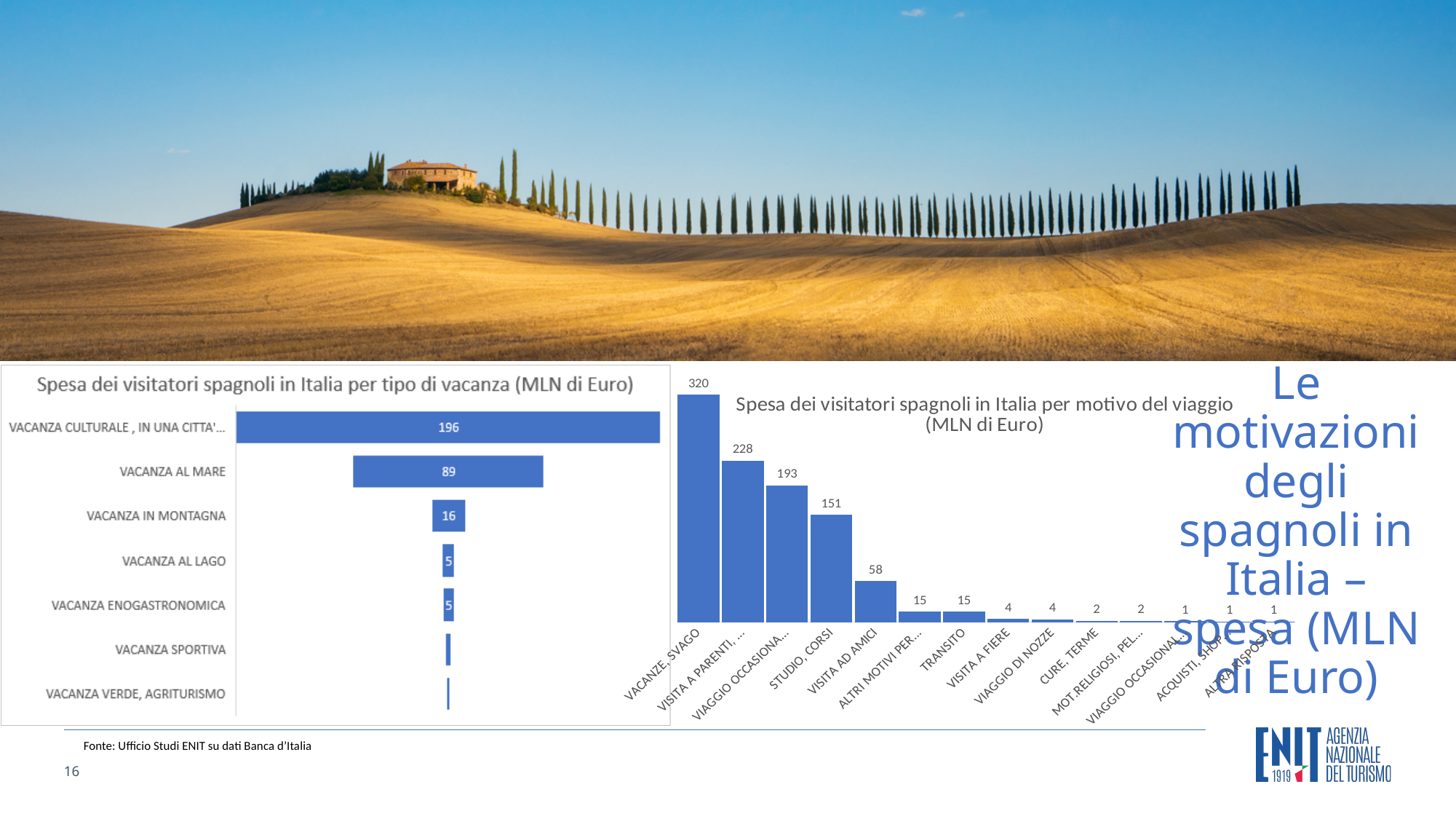
What kind of chart is 'Spesa dei visitatori spagnoli in Italia per tipo di vacanza'? Bar chart In the chart 'Spesa dei visitatori spagnoli in Italia per motivo del viaggio', what is the value for VACANZE, SVAGO? 320 In the chart 'Spesa dei visitatori spagnoli in Italia per motivo del viaggio', do the values rise or fall from left to right? Fall In the chart 'Spesa dei visitatori spagnoli in Italia per tipo di vacanza', how many categories are shown? 7 In the chart 'Spesa dei visitatori spagnoli in Italia per motivo del viaggio', what is the value for STUDIO, CORSI? 151 In the chart 'Spesa dei visitatori spagnoli in Italia per motivo del viaggio', what is the difference between VACANZE, SVAGO and VISITA A PARENTI? 92 In the chart 'Spesa dei visitatori spagnoli in Italia per tipo di vacanza', which category has the highest value? VACANZA CULTURALE, IN UNA CITTA'... In the chart 'Spesa dei visitatori spagnoli in Italia per tipo di vacanza', what is the value for VACANZA AL MARE? 89 In the chart 'Spesa dei visitatori spagnoli in Italia per tipo di vacanza', what is the difference between VACANZA CULTURALE and VACANZA AL MARE? 107 In the chart 'Spesa dei visitatori spagnoli in Italia per tipo di vacanza', what is the value for VACANZA IN MONTAGNA? 16 In the chart 'Spesa dei visitatori spagnoli in Italia per motivo del viaggio', what is the value for VISITA AD AMICI? 58 In the chart 'Spesa dei visitatori spagnoli in Italia per motivo del viaggio', which is larger: VISITA A PARENTI or STUDIO, CORSI? VISITA A PARENTI